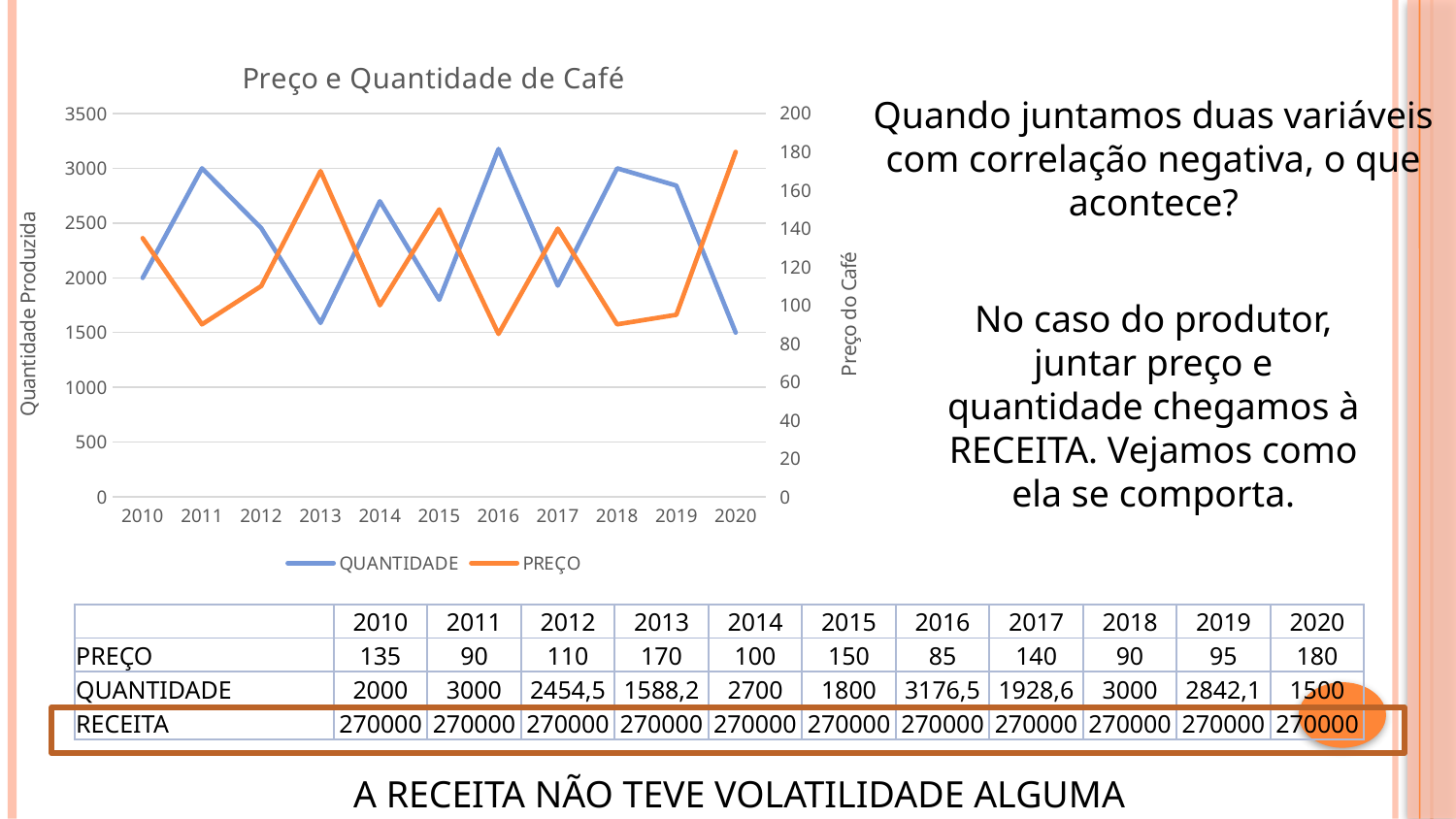
What is the PREÇO value for 2013? 170 Is the QUANTIDADE value for 2016 greater or less than 3000? greater How many series does the chart legend list? 2 In which year is QUANTIDADE lowest? 2020 What is the QUANTIDADE value for 2016? 3176,5 What type of chart is shown on the slide? line chart Which year has the larger PREÇO value, 2013 or 2014? 2013 In which year is PREÇO highest? 2020 How many years are plotted along the x axis of the chart? 11 What is the title of the chart? Preço e Quantidade de Café What is the difference between the PREÇO values for 2020 and 2016? 95 Does the QUANTIDADE series rise or fall from 2018 to 2020? fall